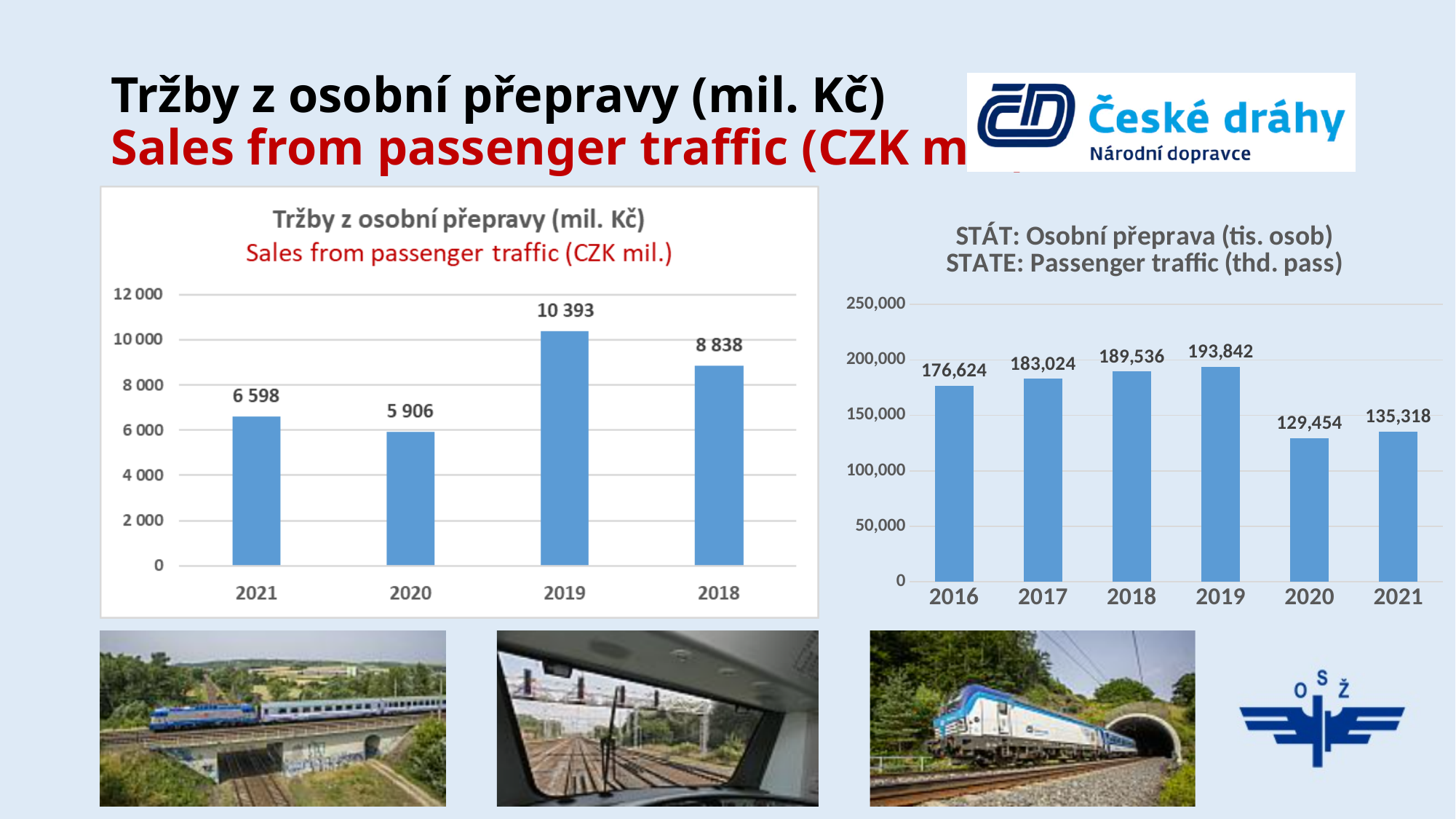
In the 'Sales from passenger traffic (CZK mil.)' chart, what is the value for 2020? 5 906 In the 'STATE: Passenger traffic (thd. pass)' chart, what is the value for 2017? 183,024 In the 'Sales from passenger traffic (CZK mil.)' chart, which year has the lowest value? 2020 In the 'Sales from passenger traffic (CZK mil.)' chart, what is the difference between the 2019 and 2018 values? 1 555 In the 'Sales from passenger traffic (CZK mil.)' chart, how many years are shown? 4 In the 'STATE: Passenger traffic (thd. pass)' chart, which year has the lowest value? 2020 In the 'Sales from passenger traffic (CZK mil.)' chart, which year has the highest value? 2019 In the 'STATE: Passenger traffic (thd. pass)' chart, which year has the highest value? 2019 In the 'STATE: Passenger traffic (thd. pass)' chart, what is the difference between the 2021 and 2020 values? 5,864 In the 'Sales from passenger traffic (CZK mil.)' chart, what is the value for 2019? 10 393 In the 'STATE: Passenger traffic (thd. pass)' chart, is the value for 2018 larger than the value for 2016? Yes What type of chart is the 'STATE: Passenger traffic (thd. pass)' chart? Bar chart